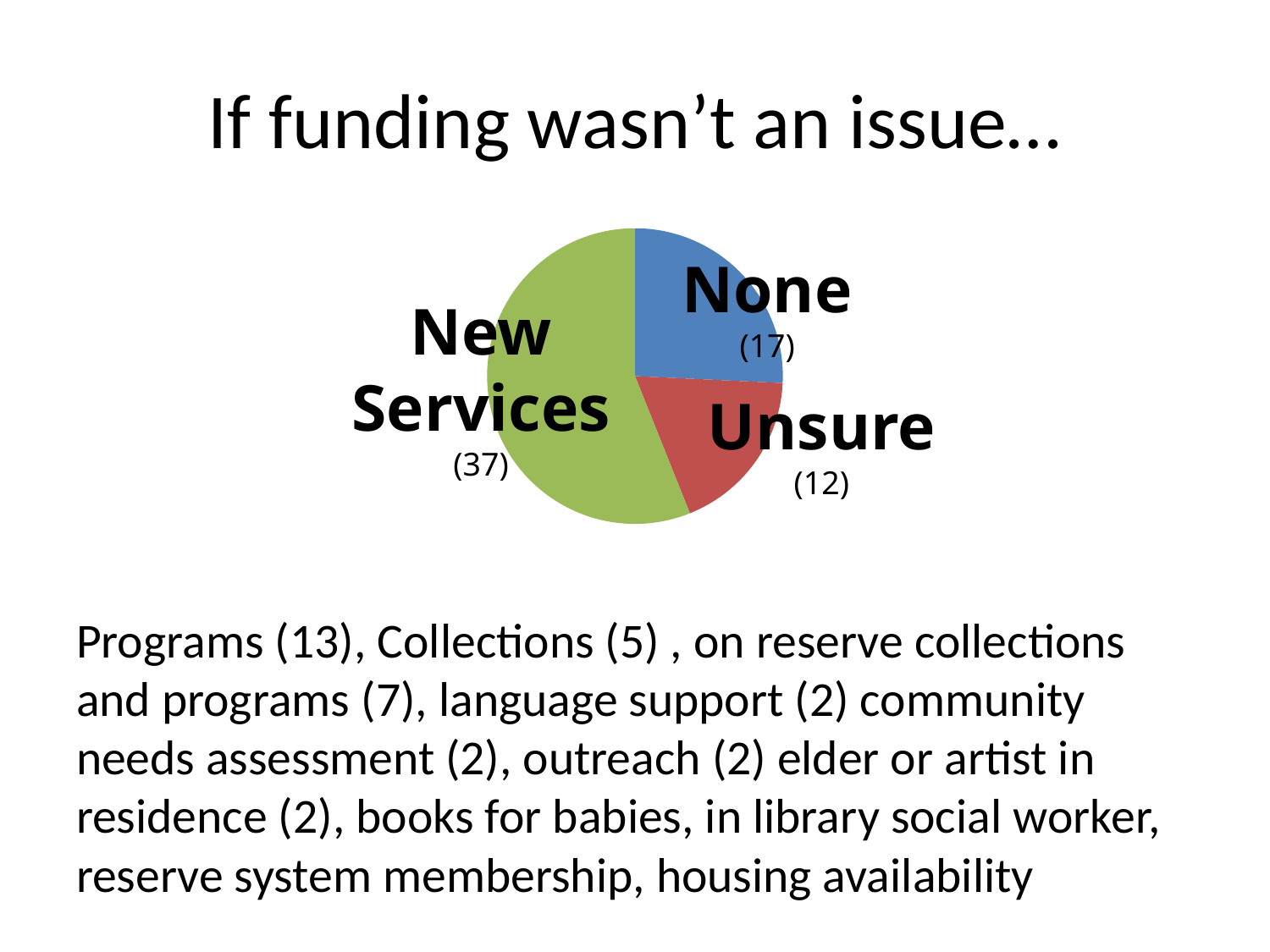
Which slice of the pie chart is the smallest? Unsure What is the value for the Unsure slice? 12 What is the difference between the None value and the Unsure value? 5 What is the value for the New Services slice? 37 Which slice of the pie chart is the largest? New Services What is the difference between the New Services value and the None value? 20 What is the total of all three slices in the pie chart? 66 Which is larger, None or Unsure? None What type of chart is shown on the slide? pie chart What is the title of the slide containing the pie chart? If funding wasn't an issue... What is the value for the None slice? 17 How many slices does the pie chart have? 3